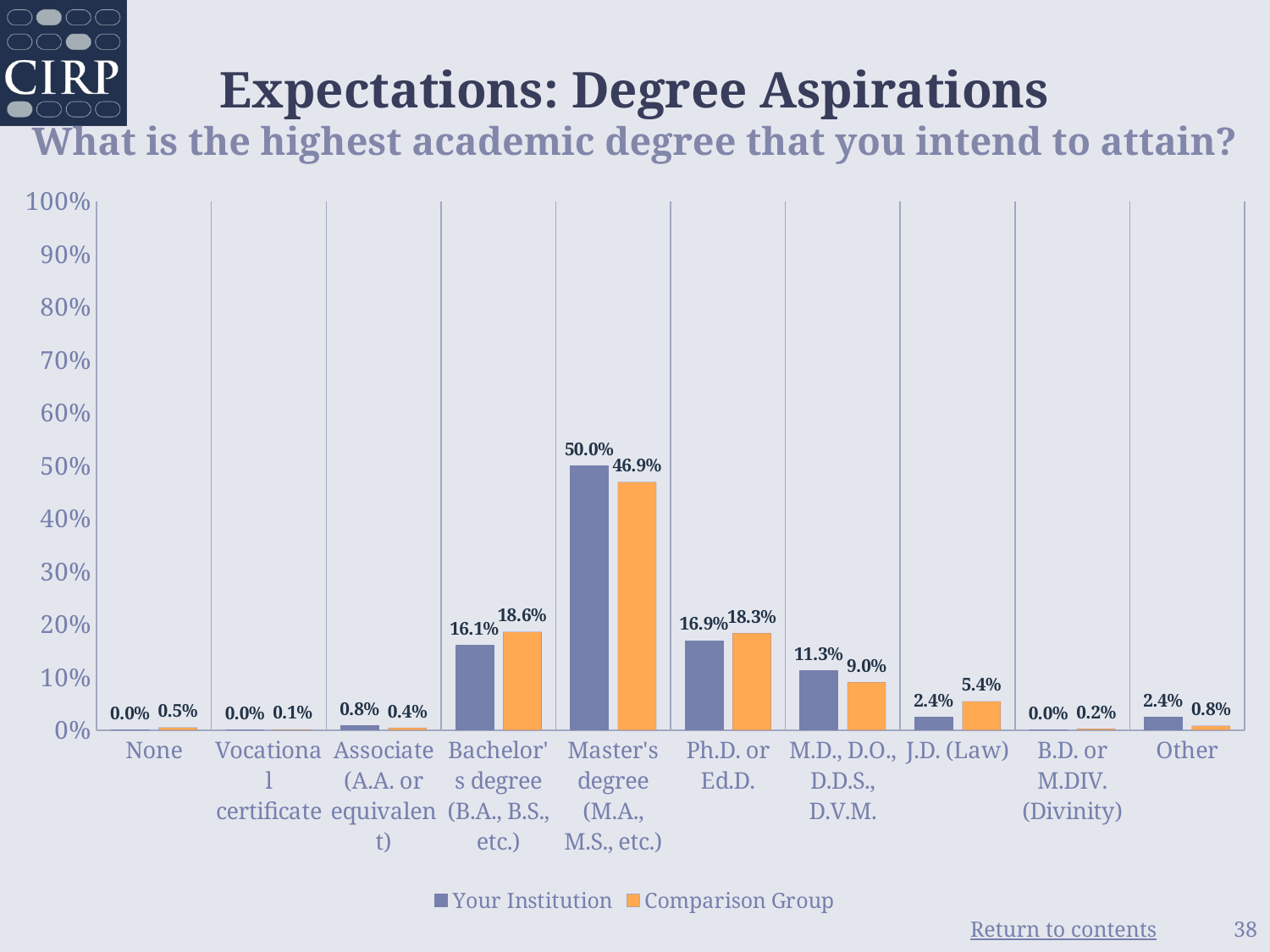
What kind of chart is shown on the slide? Bar chart What is the difference between the Comparison Group and Your Institution values for J.D. (Law)? 3.0% What is the Your Institution value for Master's degree (M.A., M.S., etc.)? 50.0% For Ph.D. or Ed.D., which is larger: Your Institution or Comparison Group? Comparison Group What is the Your Institution value for M.D., D.O., D.D.S., D.V.M.? 11.3% How many series does the legend list? 2 Which category has the lowest Comparison Group value? Vocational certificate How many categories are shown on the x axis? 10 What is the Comparison Group value for Bachelor's degree (B.A., B.S., etc.)? 18.6% Which category has the highest Your Institution value? Master's degree (M.A., M.S., etc.) For M.D., D.O., D.D.S., D.V.M., which is larger: Your Institution or Comparison Group? Your Institution What is the difference between the Your Institution and Comparison Group values for Master's degree (M.A., M.S., etc.)? 3.1%